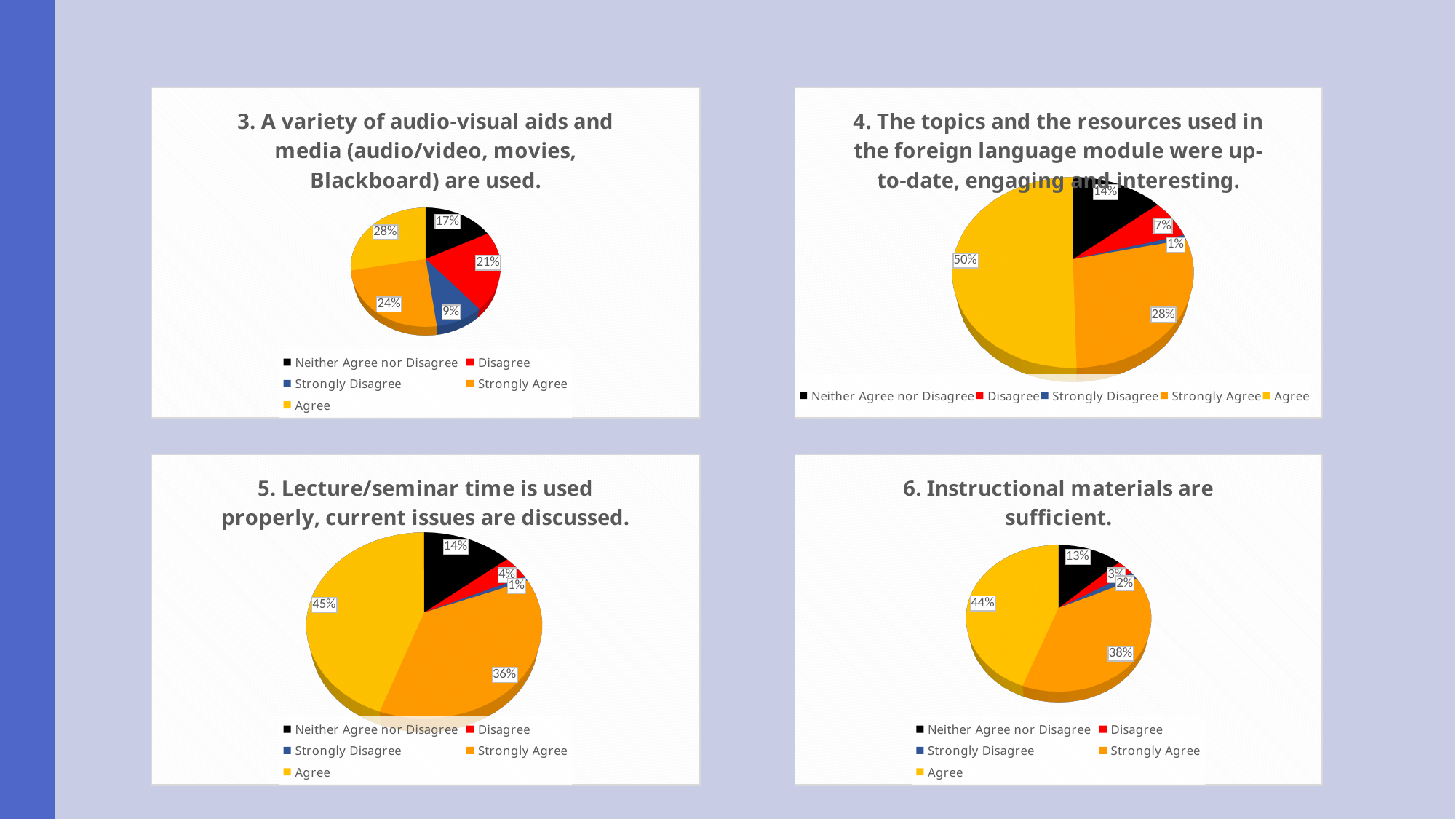
What type of chart is used for "5. Lecture/seminar time is used properly, current issues are discussed."? Pie chart In the chart titled "5. Lecture/seminar time is used properly, current issues are discussed.", which is larger, Neither Agree nor Disagree or Disagree? Neither Agree nor Disagree How many entries does the legend of the chart titled "4. The topics and the resources used in the foreign language module were up-to-date, engaging and interesting." list? 5 How many slices does the pie chart titled "6. Instructional materials are sufficient." have? 5 In the chart titled "4. The topics and the resources used in the foreign language module were up-to-date, engaging and interesting.", what is the difference between the Strongly Agree and Disagree percentages? 21% In the chart titled "4. The topics and the resources used in the foreign language module were up-to-date, engaging and interesting.", what percentage is shown for Agree? 50% In the chart titled "3. A variety of audio-visual aids and media (audio/video, movies, Blackboard) are used.", which category has the smallest slice? Strongly Disagree In the chart titled "6. Instructional materials are sufficient.", what percentage is shown for Agree? 44% In the chart titled "6. Instructional materials are sufficient.", what is the combined percentage of Agree and Strongly Agree? 82% In the chart titled "3. A variety of audio-visual aids and media (audio/video, movies, Blackboard) are used.", which category has the largest slice? Agree In the chart titled "3. A variety of audio-visual aids and media (audio/video, movies, Blackboard) are used.", what percentage is shown for Disagree? 21% In the chart titled "5. Lecture/seminar time is used properly, current issues are discussed.", what percentage is shown for Strongly Agree? 36%